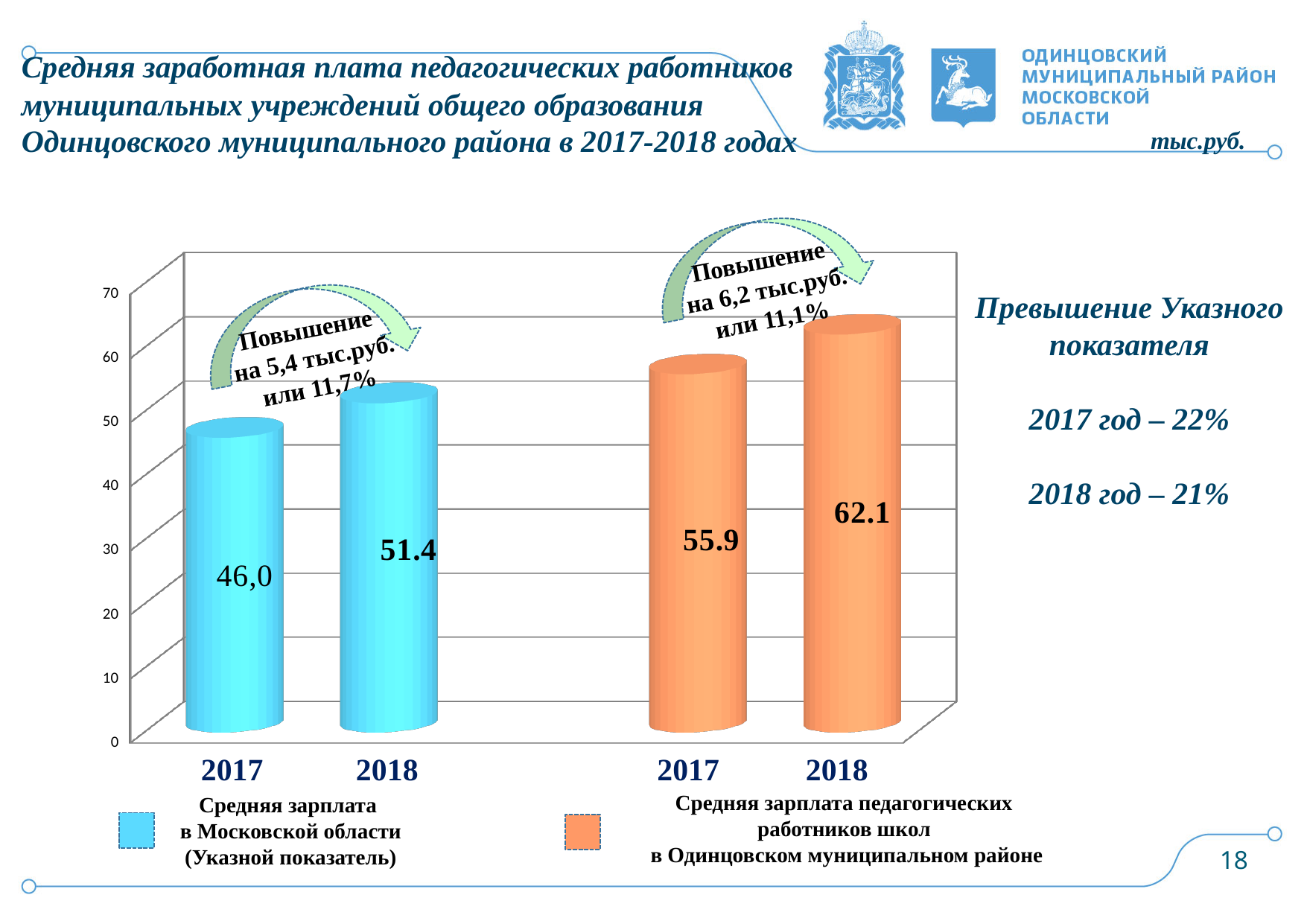
Which bar has the highest value on the chart? Odintsovo municipal district, 2018 (62.1) By how much did the average salary of teaching staff in the Odintsovo municipal district increase from 2017 to 2018? 6.2 How many series does the legend list? 2 What is the average salary in the Moscow region (Указной показатель) for 2018? 51.4 How many bars are plotted on the chart? 4 What type of chart is shown on the slide? Bar chart By how much did the average salary in the Moscow region (Указной показатель) increase from 2017 to 2018? 5.4 Which bar has the lowest value on the chart? Moscow region (Указной показатель), 2017 (46,0) What is the average salary of teaching staff in schools of the Odintsovo municipal district for 2018? 62.1 What is the average salary of teaching staff in schools of the Odintsovo municipal district for 2017? 55.9 Which is larger in 2017: the Moscow region average salary or the Odintsovo municipal district teaching staff salary? Odintsovo municipal district teaching staff salary What is the average salary in the Moscow region (Указной показатель) for 2017? 46,0